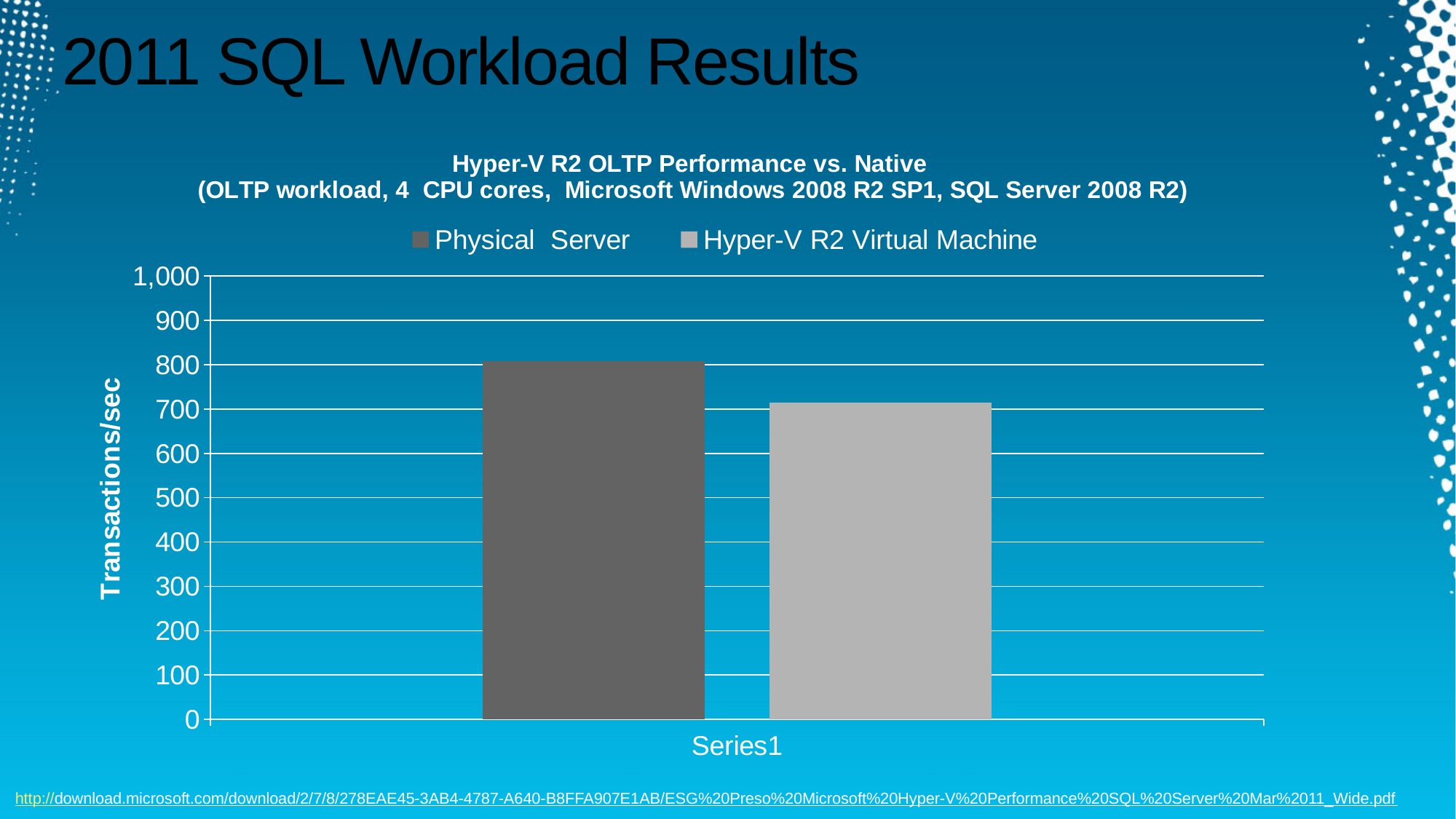
Is the value for Physical Server greater or less than 900? less How many series does the legend list? 2 How many categories are shown on the x axis? 1 Is the value for Hyper-V R2 Virtual Machine greater or less than 800? less Which series has the lowest bar? Hyper-V R2 Virtual Machine Is the value for Hyper-V R2 Virtual Machine greater or less than 600? greater Which series has the highest bar? Physical Server What is the label of the category on the x axis? Series1 What is the label of the y axis? Transactions/sec Which series has the higher value: Physical Server or Hyper-V R2 Virtual Machine? Physical Server What kind of chart is shown on the slide? bar chart